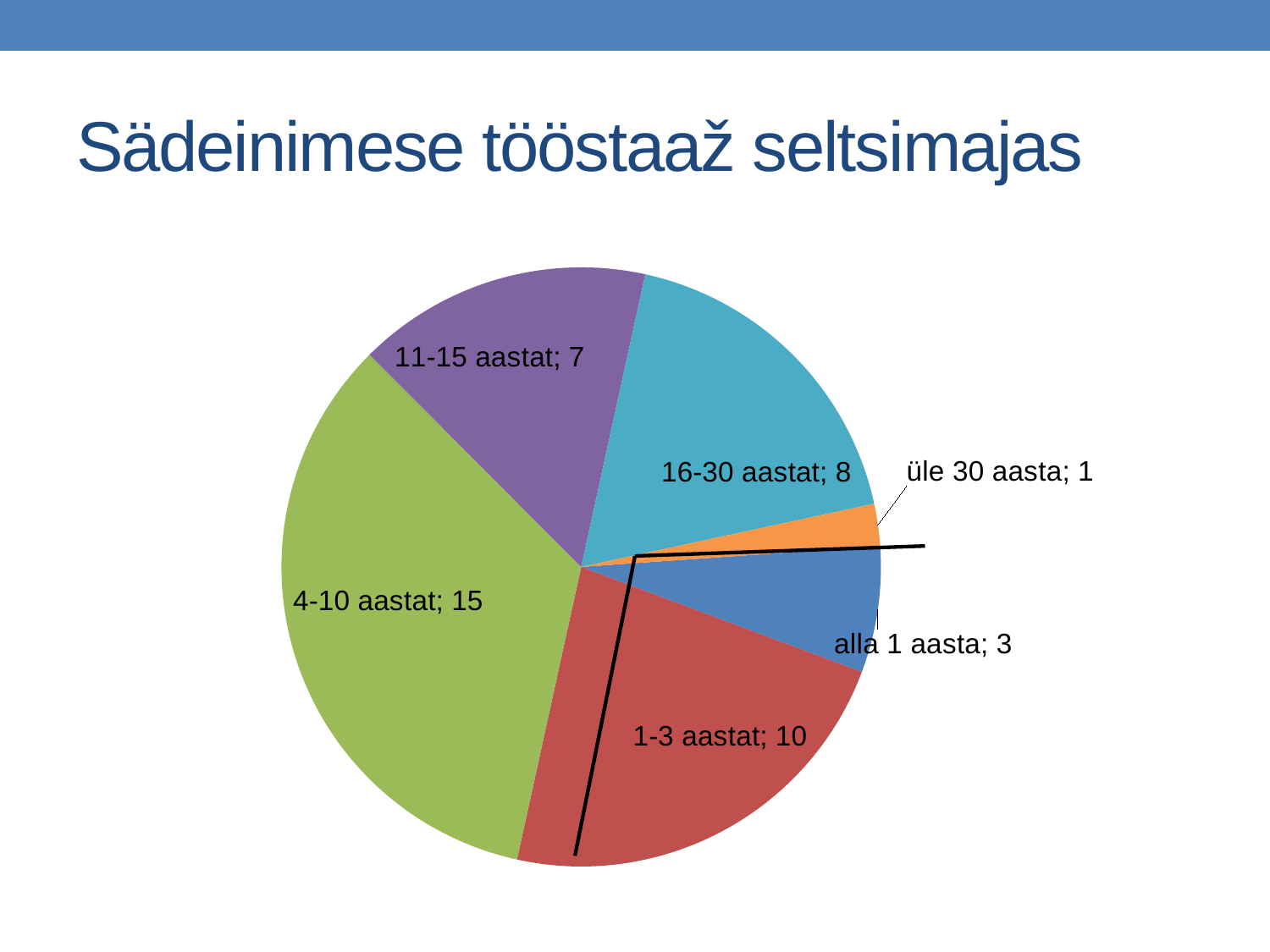
What is the value for the '1-3 aastat' slice? 10 What is the value for the 'üle 30 aasta' slice? 1 What is the value for the 'alla 1 aasta' slice? 3 Which category has the largest slice of the pie? 4-10 aastat What is the value for the '4-10 aastat' slice? 15 What is the total of all the slice values in the pie chart? 44 What type of chart is shown on the slide? pie chart How many slices does the pie chart have? 6 What is the title of the chart on the slide? Sädeinimese tööstaaž seltsimajas Which category has the smallest slice of the pie? üle 30 aasta Which is larger, the value for '16-30 aastat' or the value for '11-15 aastat'? 16-30 aastat What is the difference between the values for '4-10 aastat' and '1-3 aastat'? 5